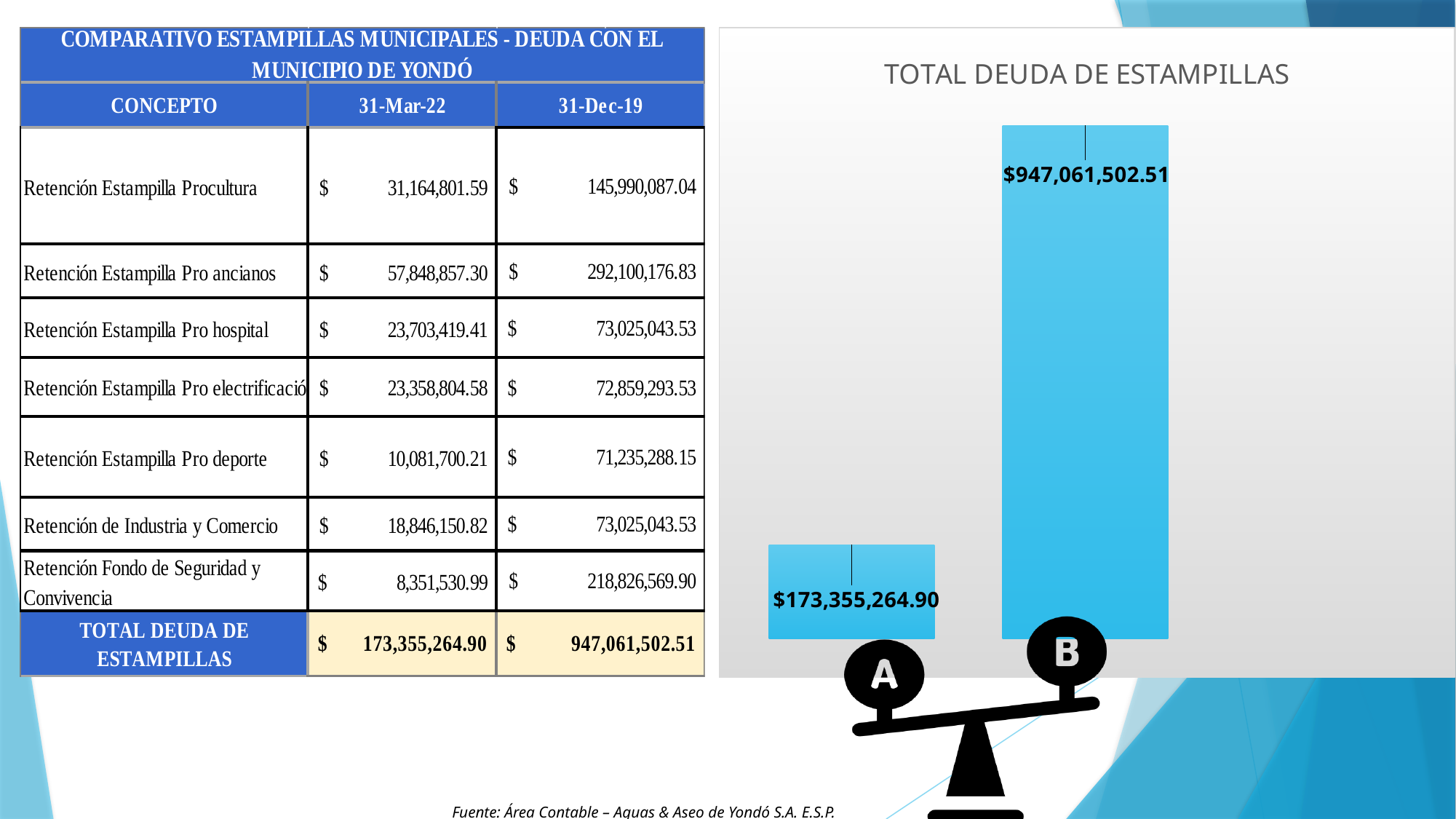
In the TOTAL DEUDA DE ESTAMPILLAS chart, what is the difference between the right bar's value and the left bar's value? $773,706,237.61 In the TOTAL DEUDA DE ESTAMPILLAS chart, what is the lowest value shown? $173,355,264.90 In the TOTAL DEUDA DE ESTAMPILLAS chart, what value is labelled on the left (shorter) bar? $173,355,264.90 In the TOTAL DEUDA DE ESTAMPILLAS chart, what is the highest value shown? $947,061,502.51 In the TOTAL DEUDA DE ESTAMPILLAS chart, what value is labelled on the right (taller) bar? $947,061,502.51 How many bars does the TOTAL DEUDA DE ESTAMPILLAS chart have? 2 In the TOTAL DEUDA DE ESTAMPILLAS chart, which bar is taller, the left one or the right one? The right one In the TOTAL DEUDA DE ESTAMPILLAS chart, do the bar values rise or fall from left to right? Rise What kind of chart is shown under the title TOTAL DEUDA DE ESTAMPILLAS? Bar chart What colour are the bars in the TOTAL DEUDA DE ESTAMPILLAS chart? Light blue What is the title of the chart on the slide? TOTAL DEUDA DE ESTAMPILLAS